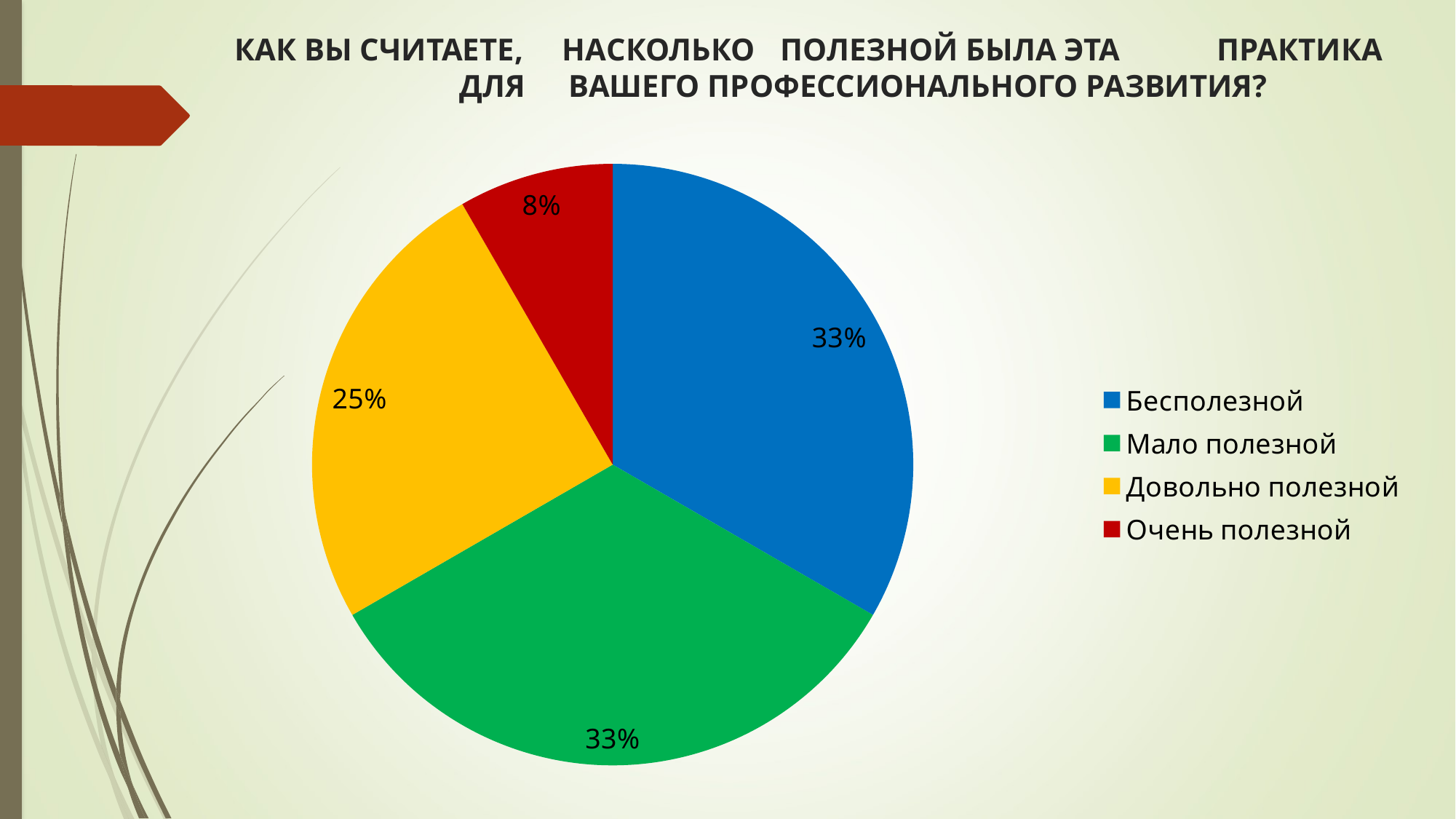
Which category has the smallest slice of the pie? Очень полезной What kind of chart is shown on the slide? pie chart What is the difference in percentage points between the "Мало полезной" slice and the "Очень полезной" slice? 25% What colour is the slice for "Довольно полезной"? yellow Which is larger: the slice for "Бесполезной" or the slice for "Довольно полезной"? Бесполезной Which is larger: the slice for "Довольно полезной" or the slice for "Очень полезной"? Довольно полезной What share of the pie is labelled "Довольно полезной"? 25% What share of the pie is labelled "Мало полезной"? 33% How many categories does the legend of the pie chart list? 4 What share of the pie is labelled "Бесполезной"? 33% What is the difference in percentage points between the "Довольно полезной" slice and the "Очень полезной" slice? 17%